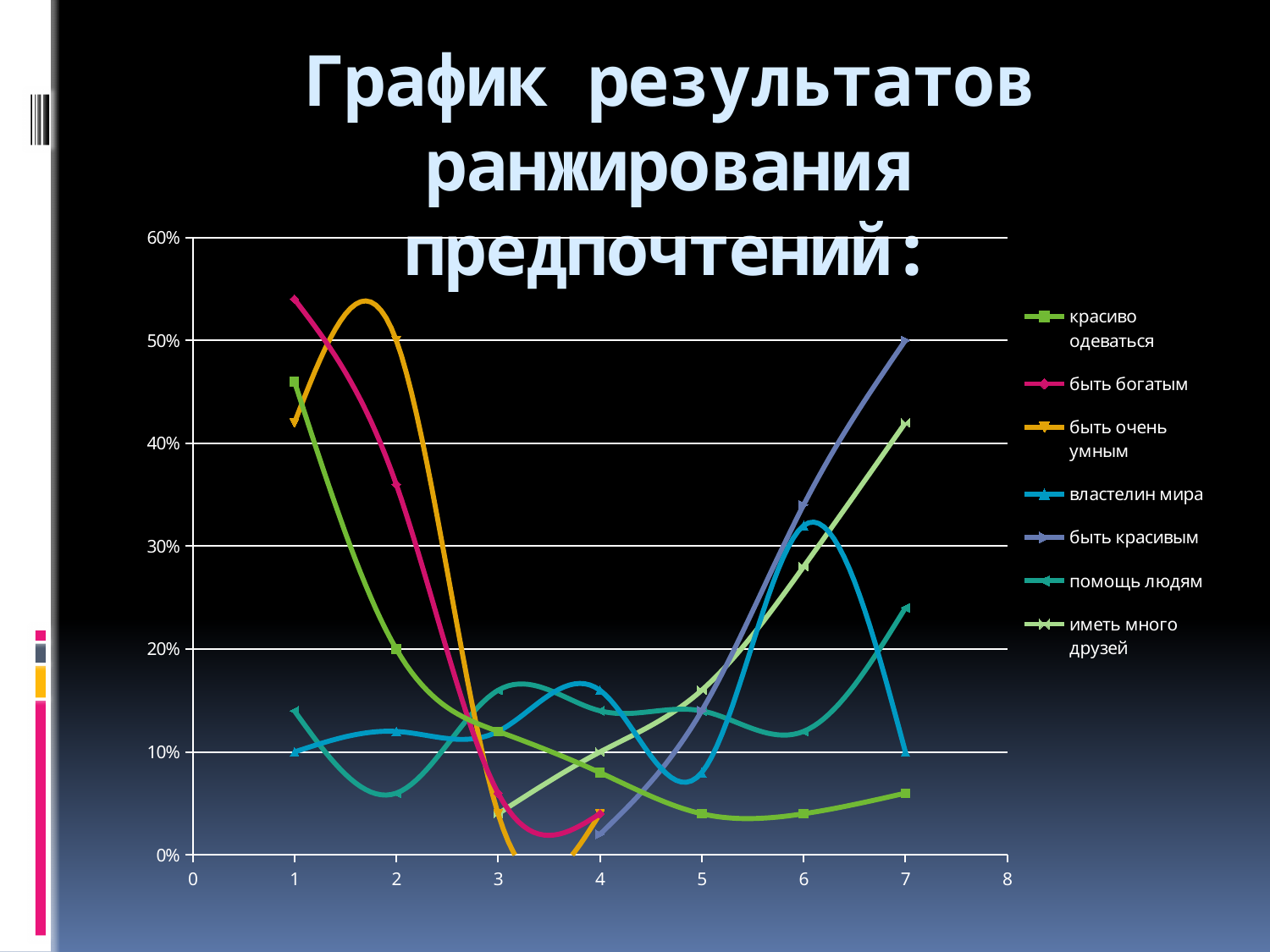
What kind of chart is shown on the slide? line chart Is the value for "помощь людям" at x = 2 greater or less than 10%? less What is the value of the "быть красивым" series at x = 7? 50% What colour is the line for "быть богатым"? pink Is the value for "быть богатым" at x = 1 greater or less than 50%? greater Is the value for "быть очень умным" at x = 3 greater or less than 10%? less Which series has the highest value at x = 1? быть богатым Does the "красиво одеваться" series rise or fall from x = 1 to x = 5? fall How many series does the legend list? 7 What is the value of the "властелин мира" series at x = 7? 10% At x = 7, which is larger: "быть красивым" or "иметь много друзей"? быть красивым